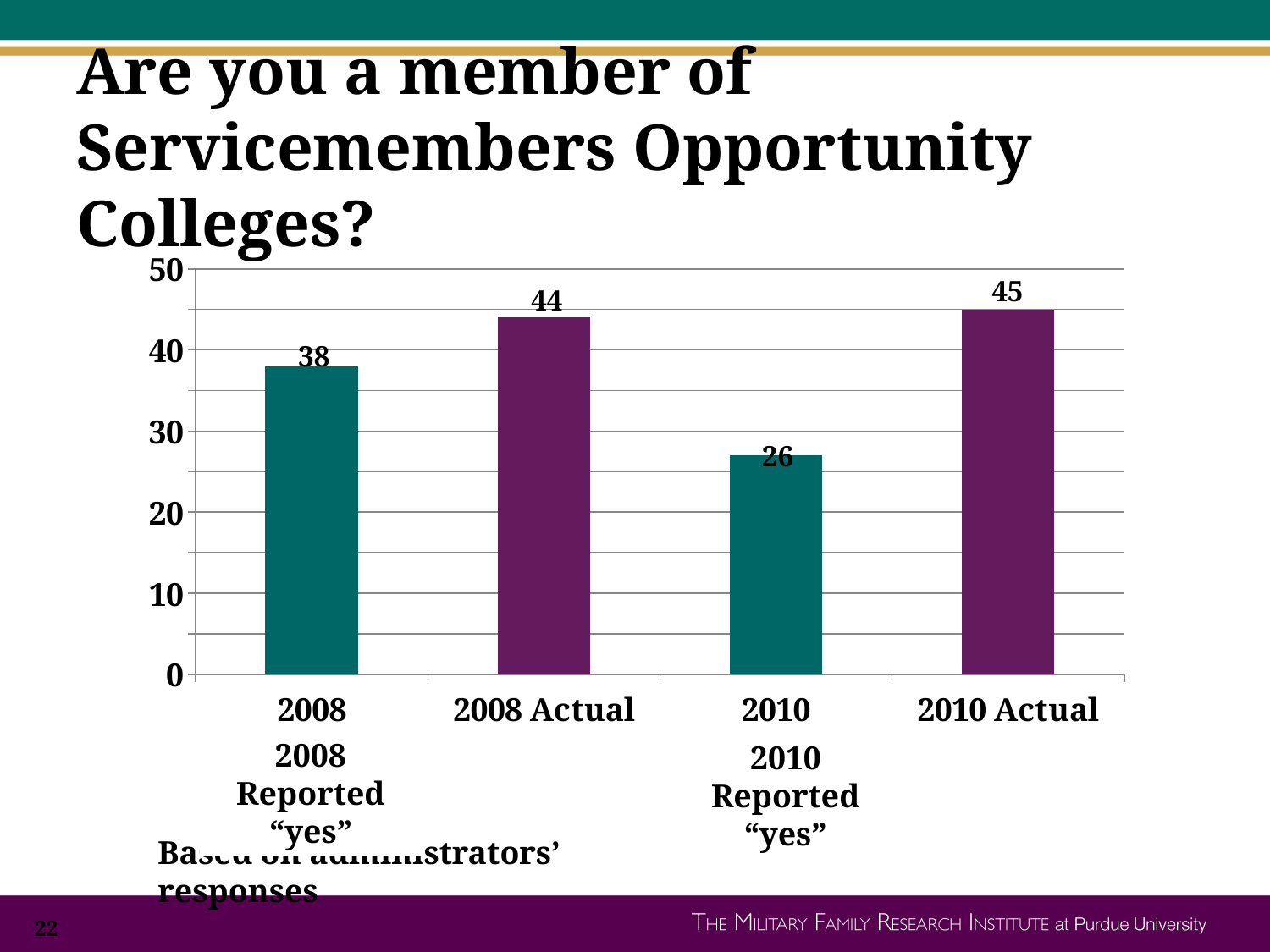
What kind of chart is shown on the slide? bar chart Which category has the highest value? 2010 Actual What is the value for 2010? 26 How many bars are shown in the chart? 4 Which is larger, the value for 2008 or the value for 2010? 2008 What is the value for 2008? 38 What is the value for 2008 Actual? 44 Is the value for 2008 greater or less than 40? less Which category has the lowest value? 2010 What is the difference between the values for 2008 Actual and 2008? 6 What is the difference between the values for 2010 Actual and 2010? 19 What is the value for 2010 Actual? 45